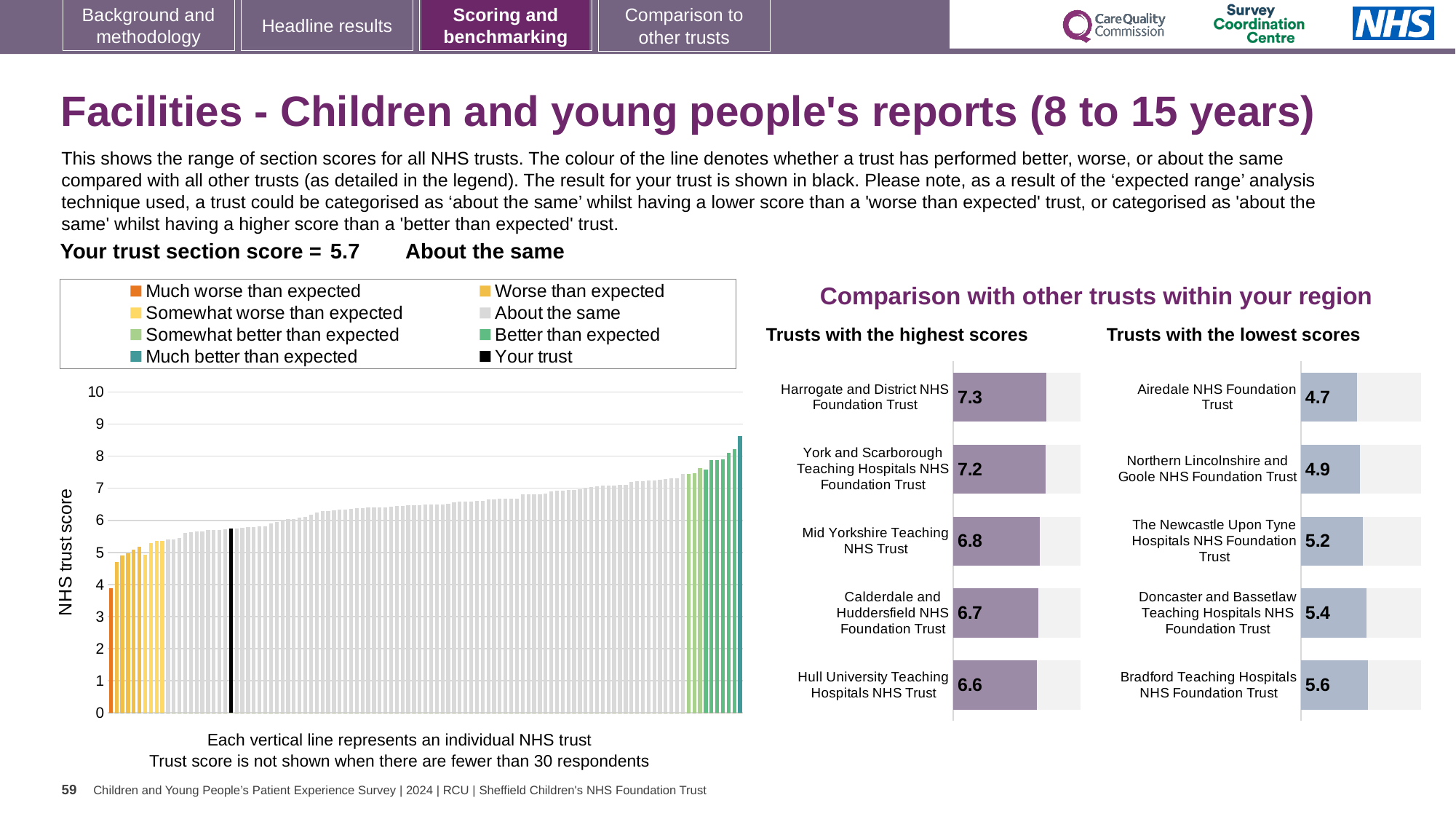
In the 'Trusts with the lowest scores' chart, which trust has the lowest score? Airedale NHS Foundation Trust In the 'Trusts with the highest scores' chart, what is the score for Hull University Teaching Hospitals NHS Trust? 6.6 In the 'Trusts with the highest scores' chart, what is the score for Harrogate and District NHS Foundation Trust? 7.3 In the 'Trusts with the lowest scores' chart, what is the score for Airedale NHS Foundation Trust? 4.7 In the main chart of NHS trust scores on the left, is the value for 'Your trust' greater or less than 5? greater In the 'Trusts with the highest scores' chart, which trust has the highest score? Harrogate and District NHS Foundation Trust In the 'Trusts with the lowest scores' chart, which has the larger score: Northern Lincolnshire and Goole NHS Foundation Trust or Bradford Teaching Hospitals NHS Foundation Trust? Bradford Teaching Hospitals NHS Foundation Trust How many entries does the legend of the main chart on the left list? 8 In the 'Trusts with the highest scores' chart, what is the difference between the scores of Harrogate and District NHS Foundation Trust and Mid Yorkshire Teaching NHS Trust? 0.5 In the 'Trusts with the highest scores' chart, how many trusts are shown? 5 In the main chart of NHS trust scores on the left, do the values rise or fall from left to right? rise In the 'Trusts with the lowest scores' chart, what is the score for Doncaster and Bassetlaw Teaching Hospitals NHS Foundation Trust? 5.4